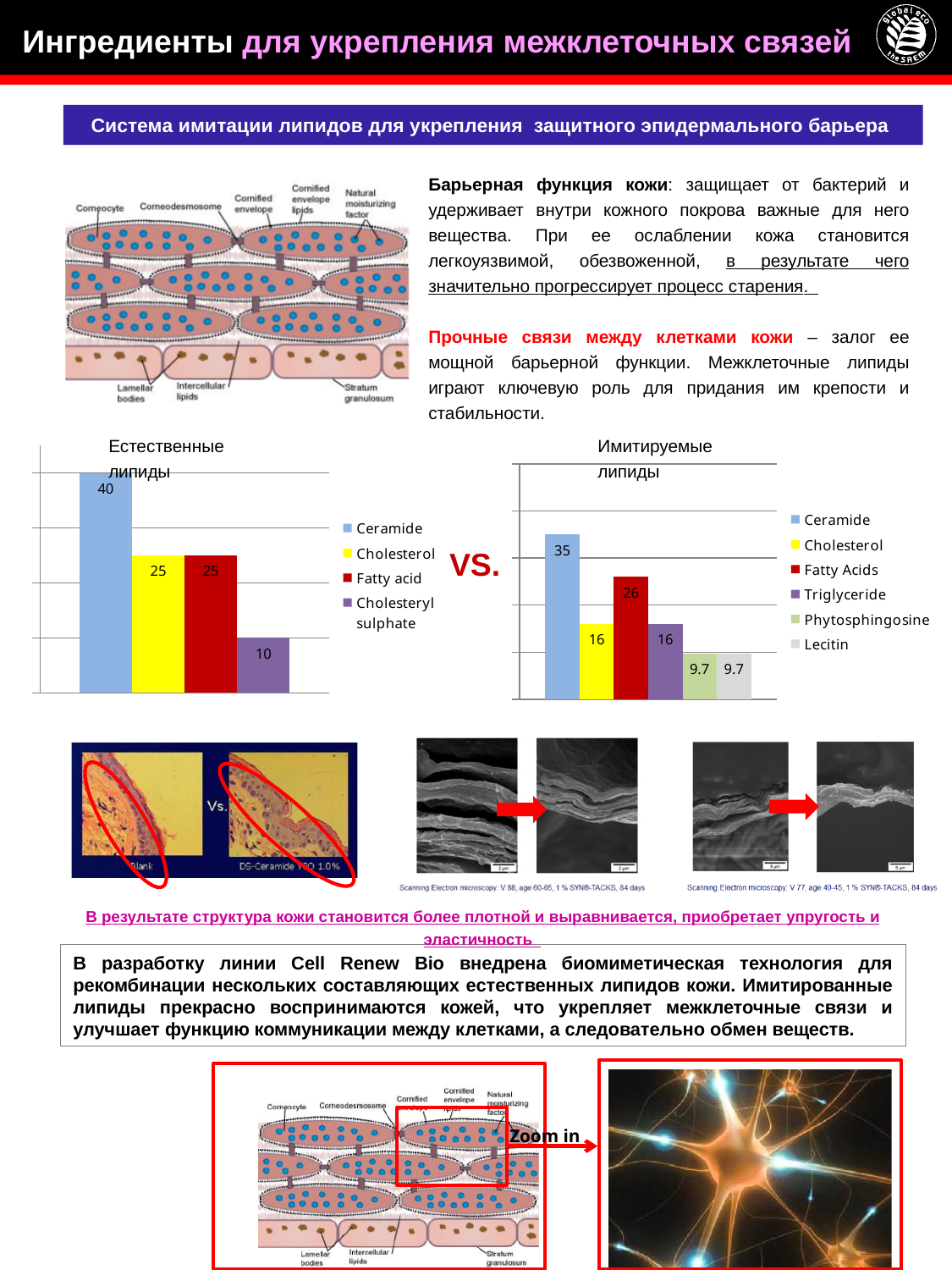
What kind of chart is the "Имитируемые липиды" chart? Bar chart In the "Естественные липиды" chart, what is the value for Ceramide? 40 How many series does the legend of the "Имитируемые липиды" chart list? 6 In the "Имитируемые липиды" chart, what is the value for Phytosphingosine? 9.7 In the "Естественные липиды" chart, what is the value for Cholesteryl sulphate? 10 In the "Имитируемые липиды" chart, which series has the highest value? Ceramide In the "Имитируемые липиды" chart, what is the value for Fatty Acids? 26 In the "Естественные липиды" chart, which series has the highest value? Ceramide In the "Имитируемые липиды" chart, which is larger, Fatty Acids or Triglyceride? Fatty Acids In the "Естественные липиды" chart, what is the difference between Ceramide and Cholesterol? 15 In the "Имитируемые липиды" chart, what is the difference between Ceramide and Fatty Acids? 9 How many series does the legend of the "Естественные липиды" chart list? 4